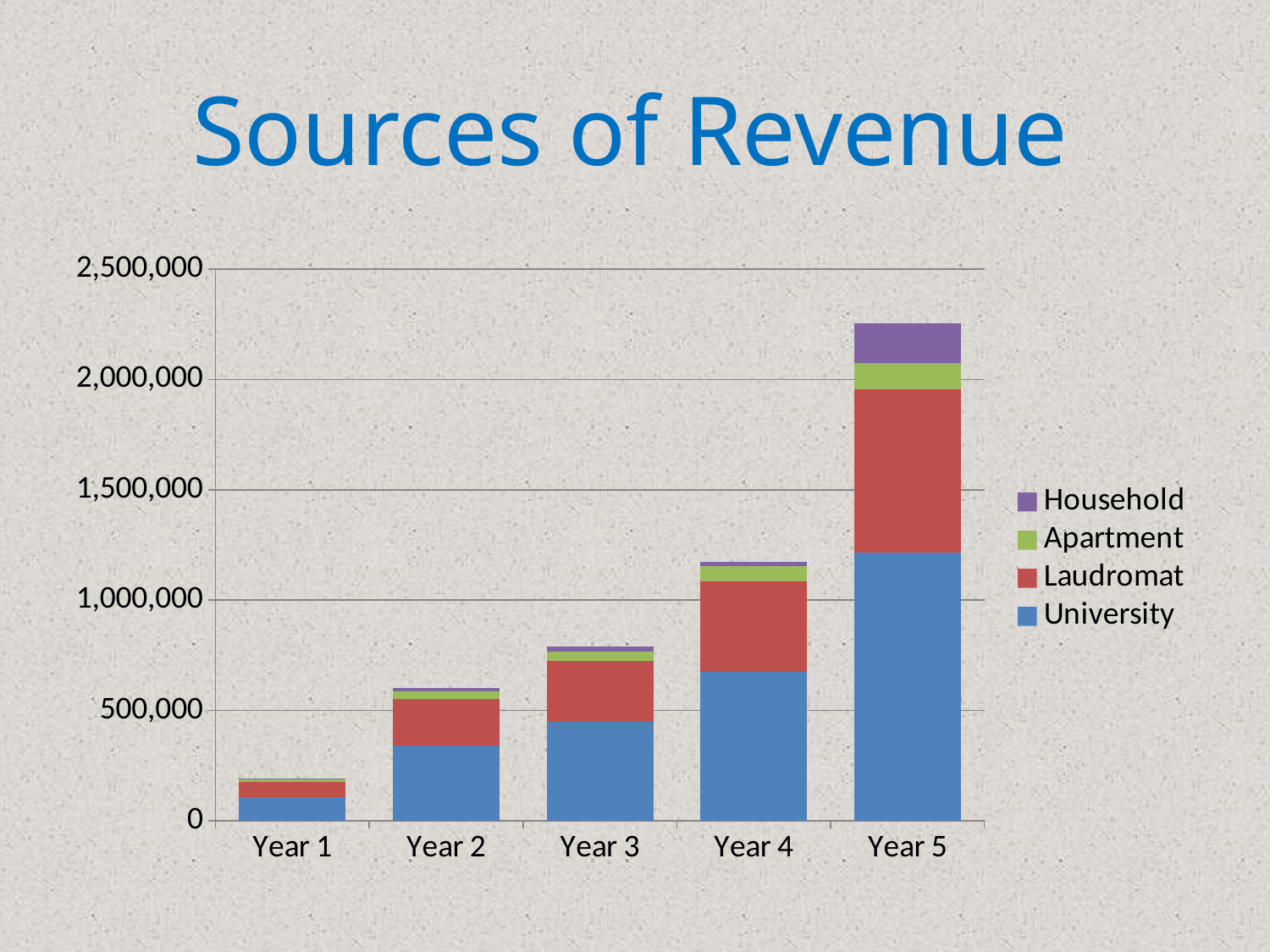
What is the title of the chart? Sources of Revenue Is the total revenue for Year 3 greater or less than 1,000,000? less Is the total revenue for Year 5 greater or less than 2,000,000? greater Which year has the highest total revenue? Year 5 How many series does the legend list? 4 What kind of chart is shown on the slide? Stacked bar chart Which year has the lowest total revenue? Year 1 Do total revenues rise or fall from Year 1 to Year 5? Rise Is the University revenue in Year 5 greater or less than 1,000,000? greater How many years are shown on the x axis? 5 Which series contributes the largest share of revenue in Year 5? University